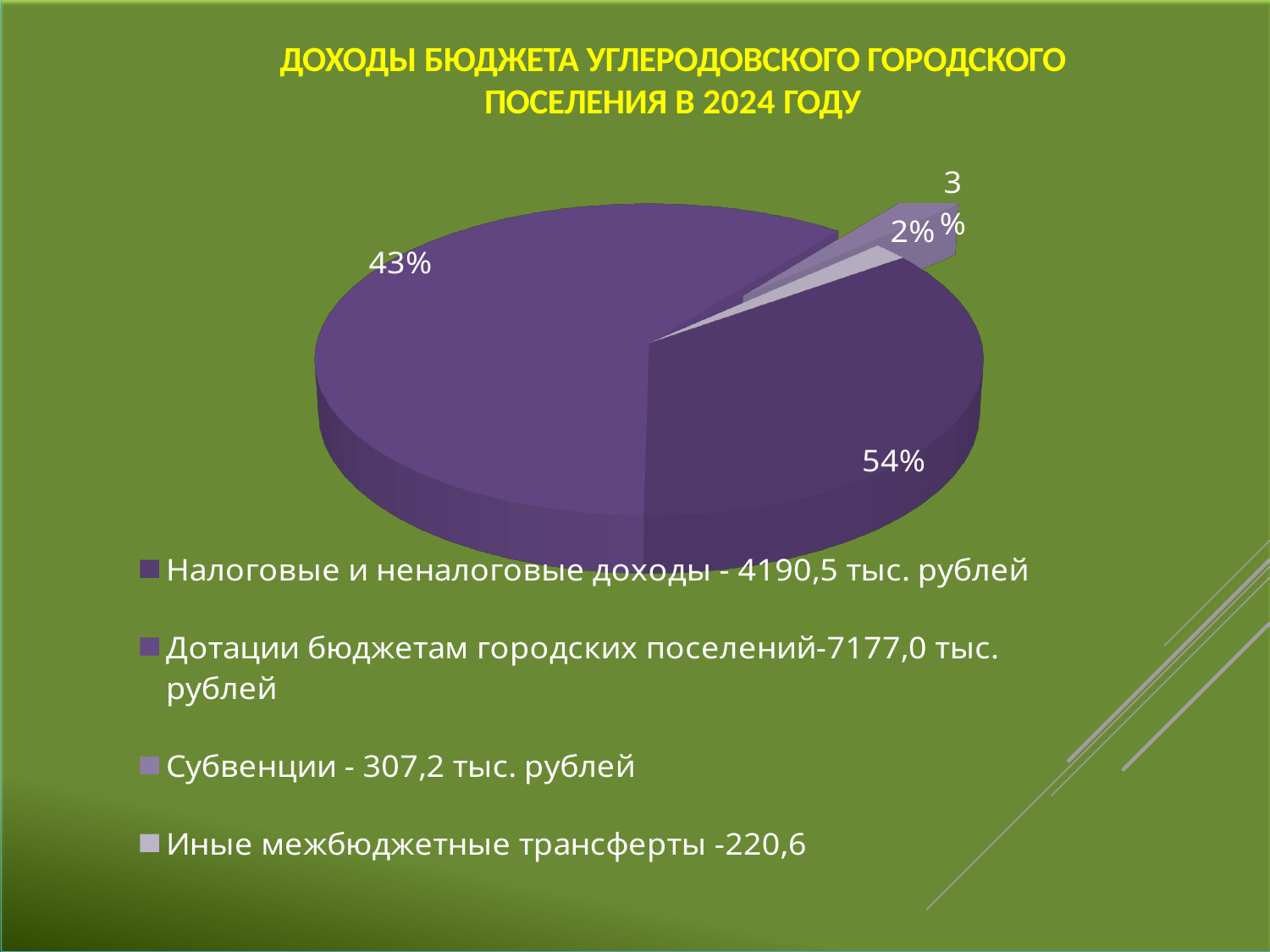
How many slices does the pie chart have? 4 What is the title of the slide? ДОХОДЫ БЮДЖЕТА УГЛЕРОДОВСКОГО ГОРОДСКОГО ПОСЕЛЕНИЯ В 2024 ГОДУ Which slice is larger: Налоговые и неналоговые доходы or Дотации бюджетам городских поселений? Дотации бюджетам городских поселений What is the smallest percentage shown on the pie chart? 2% According to the legend, what amount is given for Субвенции? 307,2 тыс. рублей According to the legend, what amount is given for Иные межбюджетные трансферты? 220,6 How many entries does the legend list? 4 What kind of chart is shown on the slide? pie chart What is the largest percentage shown on the pie chart? 54% What is the difference in percentage points between the 54% slice and the 43% slice? 11